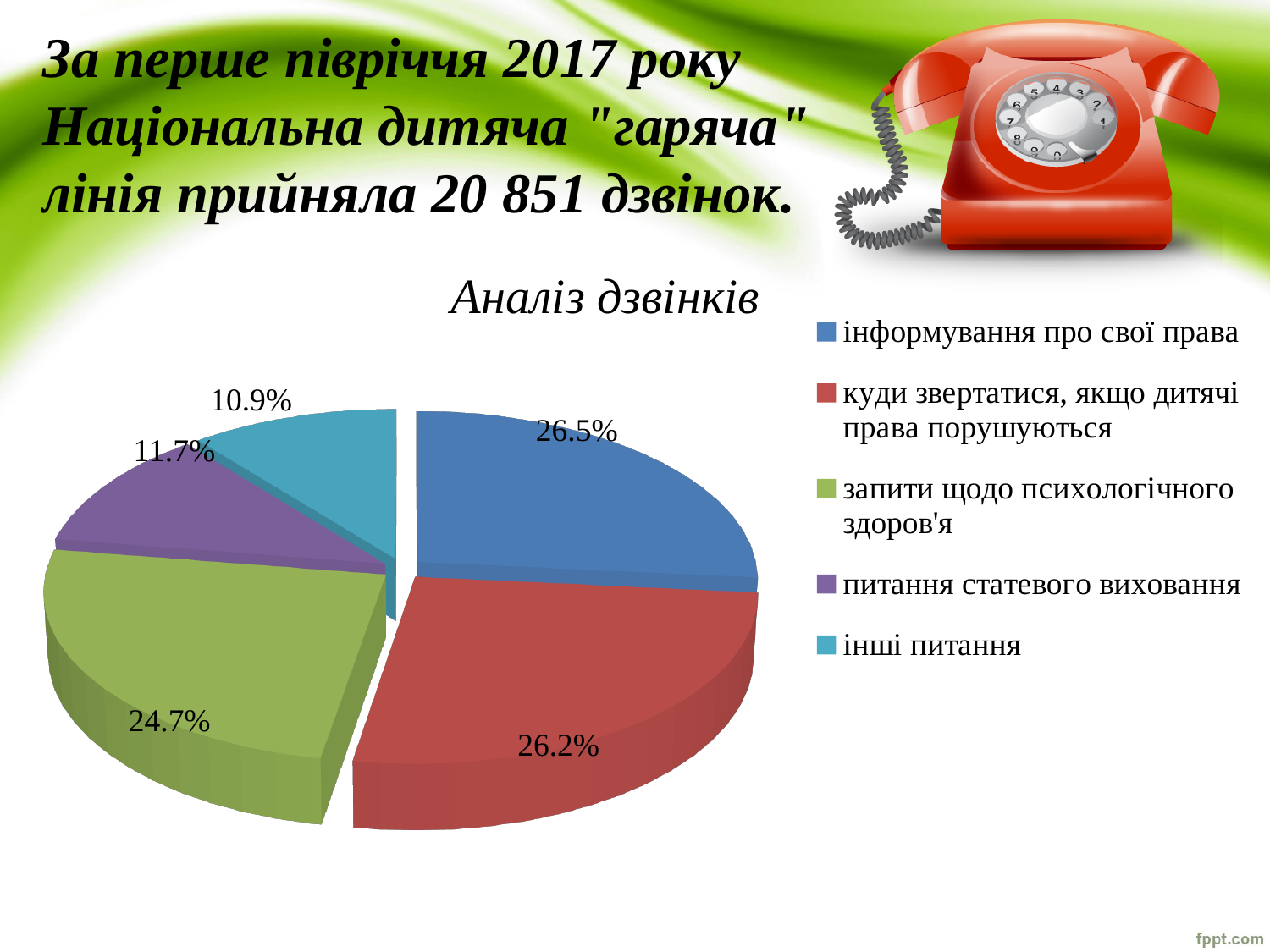
What share of calls is for "куди звертатися, якщо дитячі права порушуються"? 26.2% What share of calls is for "інші питання"? 10.9% What is the title of the chart? Аналіз дзвінків How many slices does the pie chart have? 5 What share of calls is for "питання статевого виховання"? 11.7% What share of calls is for "інформування про свої права"? 26.5% What kind of chart is shown on the slide? pie chart What share of calls is for "запити щодо психологічного здоров'я"? 24.7% Which is larger: the share for "запити щодо психологічного здоров'я" or for "питання статевого виховання"? запити щодо психологічного здоров'я What is the difference in percentage points between "інформування про свої права" and "інші питання"? 15.6% Which category has the smallest share of calls? інші питання Which category has the largest share of calls? інформування про свої права